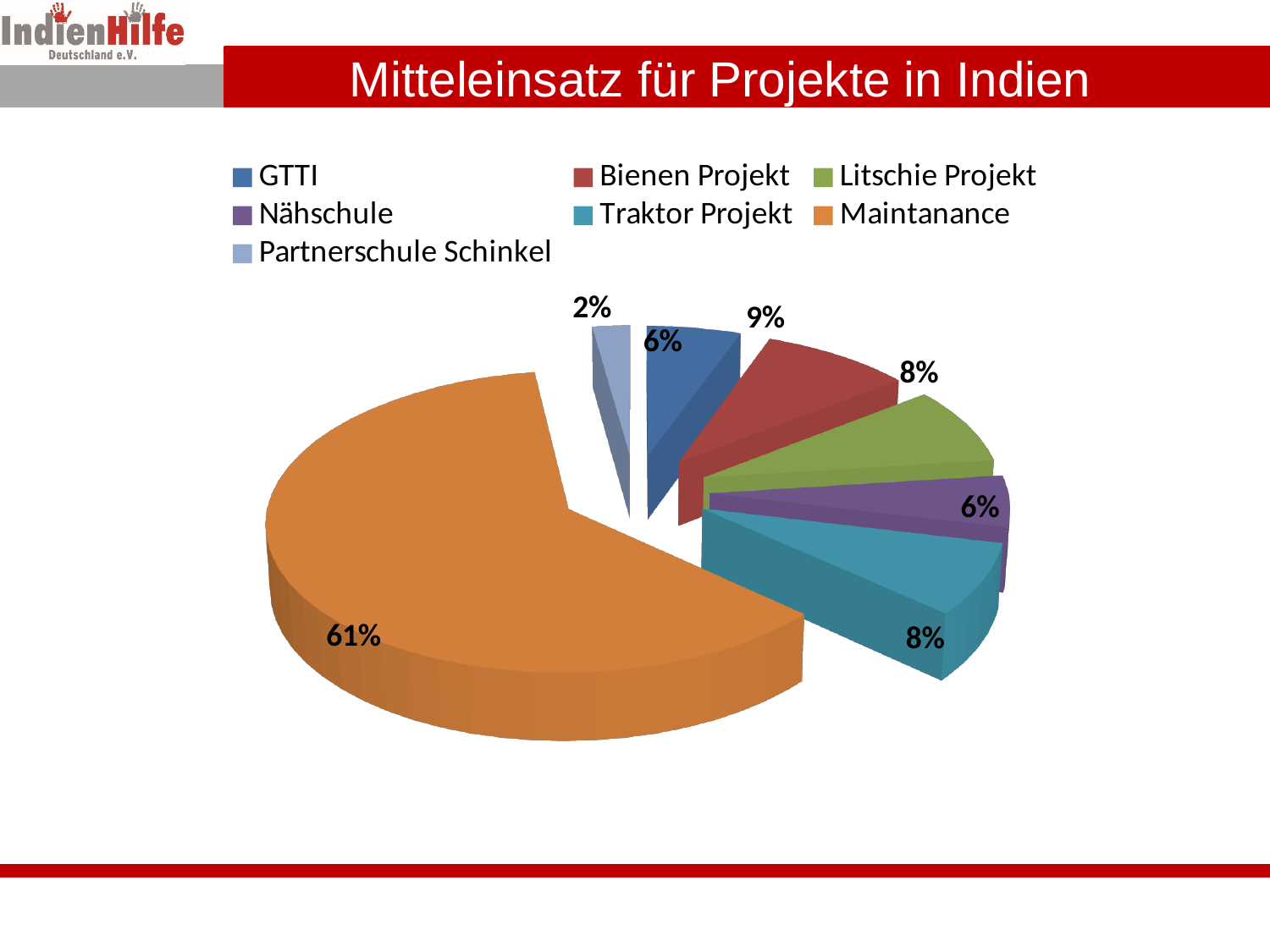
Which category has the smallest slice of the pie? Partnerschule Schinkel How many categories are shown in the pie chart? 7 Which is larger, the share for Bienen Projekt or the share for Litschie Projekt? Bienen Projekt What share of the pie does Maintanance account for? 61% What is the value shown for Partnerschule Schinkel? 2% Which category has the largest slice of the pie? Maintanance What is the value shown for GTTI? 6% What kind of chart is shown on the slide? Pie chart What is the value shown for Bienen Projekt? 9% What is the title of the chart? Mitteleinsatz für Projekte in Indien What is the value shown for Traktor Projekt? 8% What is the difference between the shares of Maintanance and Bienen Projekt? 52%